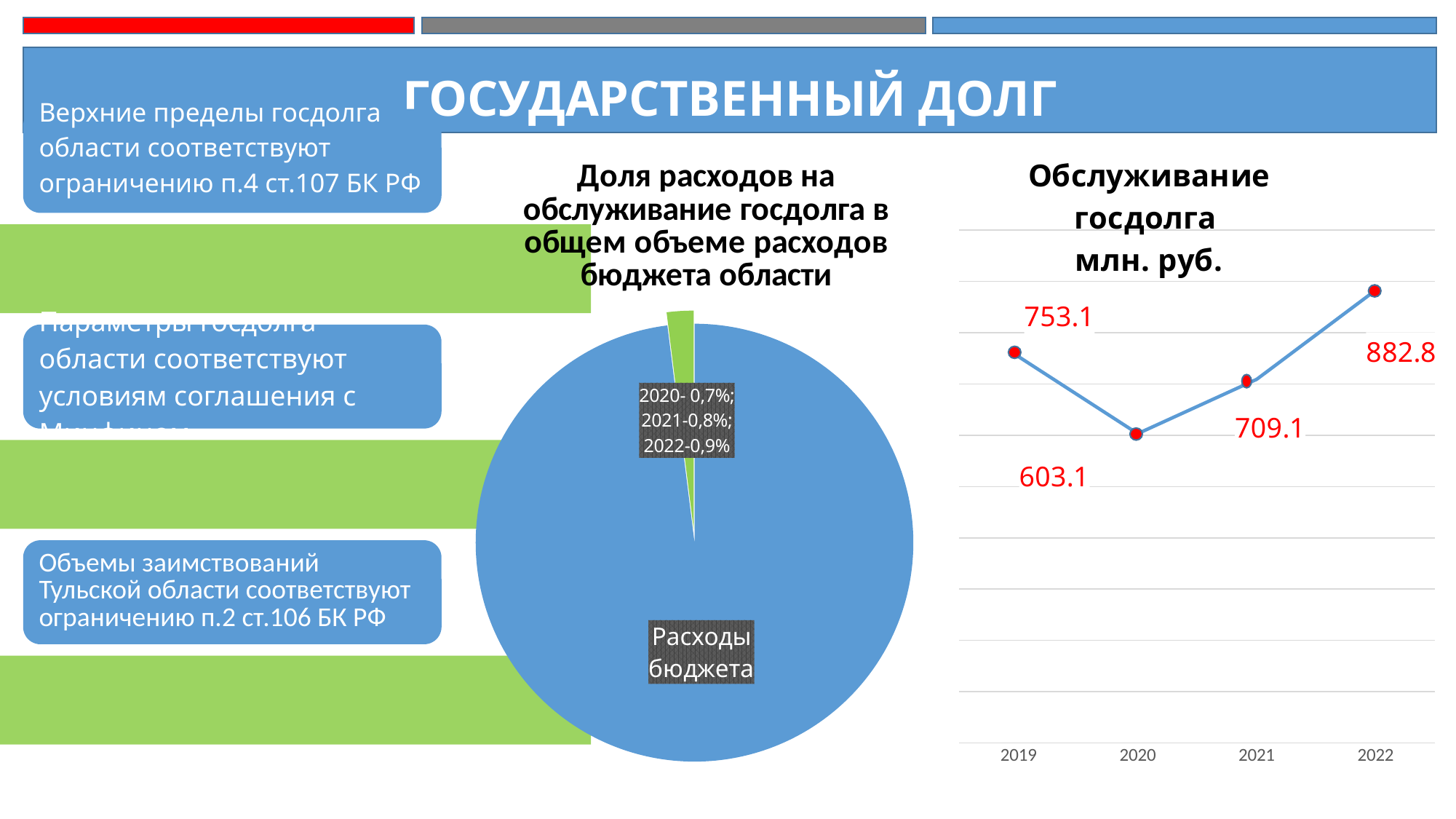
In the chart titled "Обслуживание госдолга млн. руб.", do the values rise or fall from 2020 to 2022? Rise In the pie chart titled "Доля расходов на обслуживание госдолга в общем объеме расходов бюджета области", what is the label of the large blue slice? Расходы бюджета What kind of chart is the one titled "Доля расходов на обслуживание госдолга в общем объеме расходов бюджета области"? Pie chart In the chart titled "Обслуживание госдолга млн. руб.", which year has the lowest value? 2020 In the chart titled "Обслуживание госдолга млн. руб.", which year has the highest value? 2022 In the chart titled "Обслуживание госдолга млн. руб.", what is the difference between the values for 2022 and 2021? 173.7 In the chart titled "Обслуживание госдолга млн. руб.", what is the value for 2020? 603.1 In the chart titled "Обслуживание госдолга млн. руб.", what is the value for 2019? 753.1 In the chart titled "Обслуживание госдолга млн. руб.", how many years are plotted? 4 In the chart titled "Обслуживание госдолга млн. руб.", what is the value for 2022? 882.8 What kind of chart is the one titled "Обслуживание госдолга млн. руб."? Line chart In the chart titled "Обслуживание госдолга млн. руб.", which is larger, the value for 2019 or the value for 2021? 2019